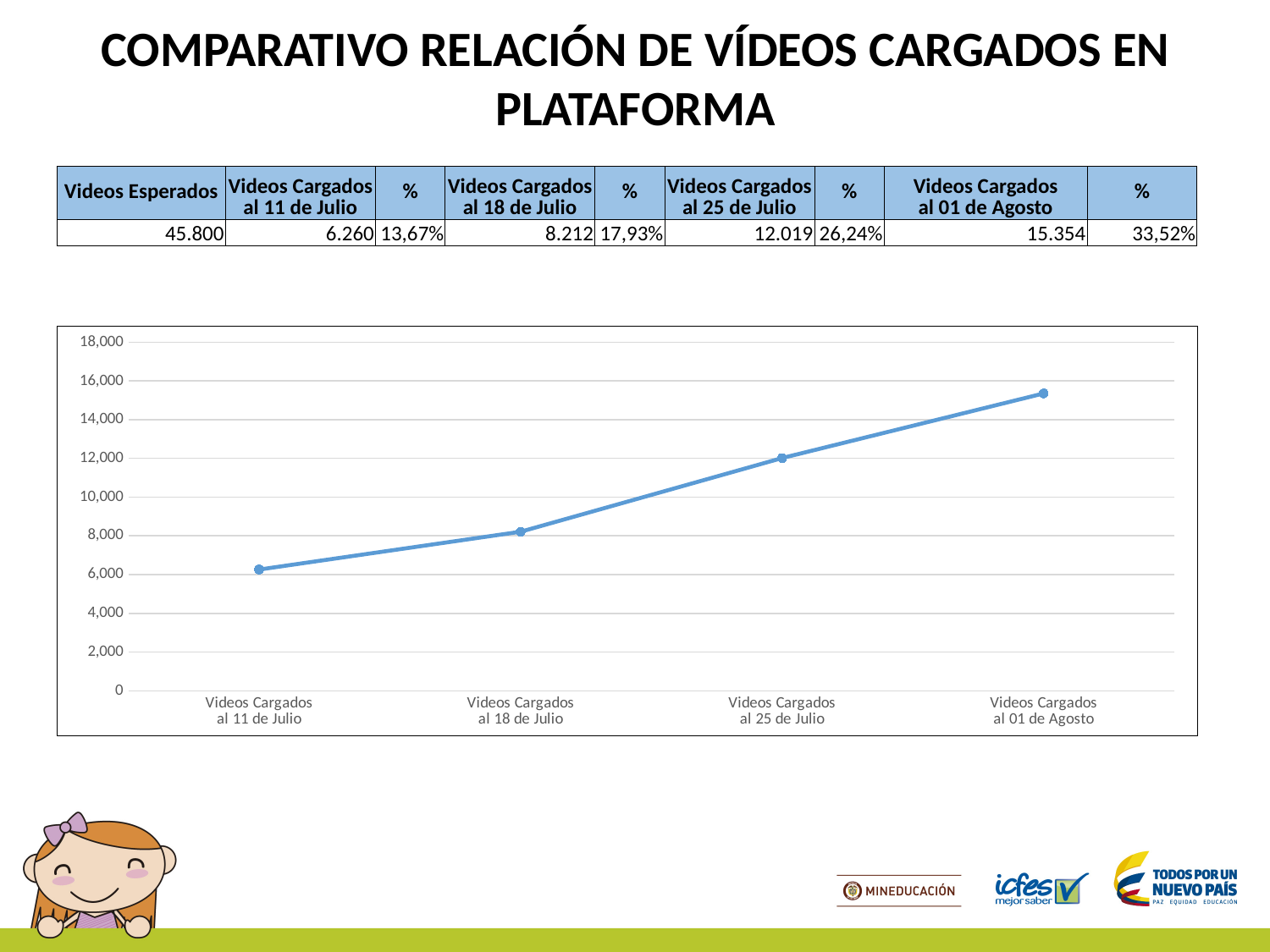
According to the table, how many videos were loaded as of 18 de Julio? 8.212 Using the table values, what is the difference between Videos Cargados al 01 de Agosto and Videos Cargados al 11 de Julio? 9.094 Is the value for Videos Cargados al 25 de Julio greater or less than 10,000? greater Which category has the lowest value on the line chart? Videos Cargados al 11 de Julio Which category has the highest value on the line chart? Videos Cargados al 01 de Agosto Is the value for Videos Cargados al 01 de Agosto greater or less than 14,000? greater Do the values on the line chart rise or fall from left to right? rise What kind of chart is shown on the slide? line chart Which is larger: the value for Videos Cargados al 18 de Julio or Videos Cargados al 25 de Julio? Videos Cargados al 25 de Julio According to the table, how many videos were loaded as of 01 de Agosto? 15.354 How many data points are plotted on the line chart? 4 Is the value for Videos Cargados al 11 de Julio greater or less than 8,000? less